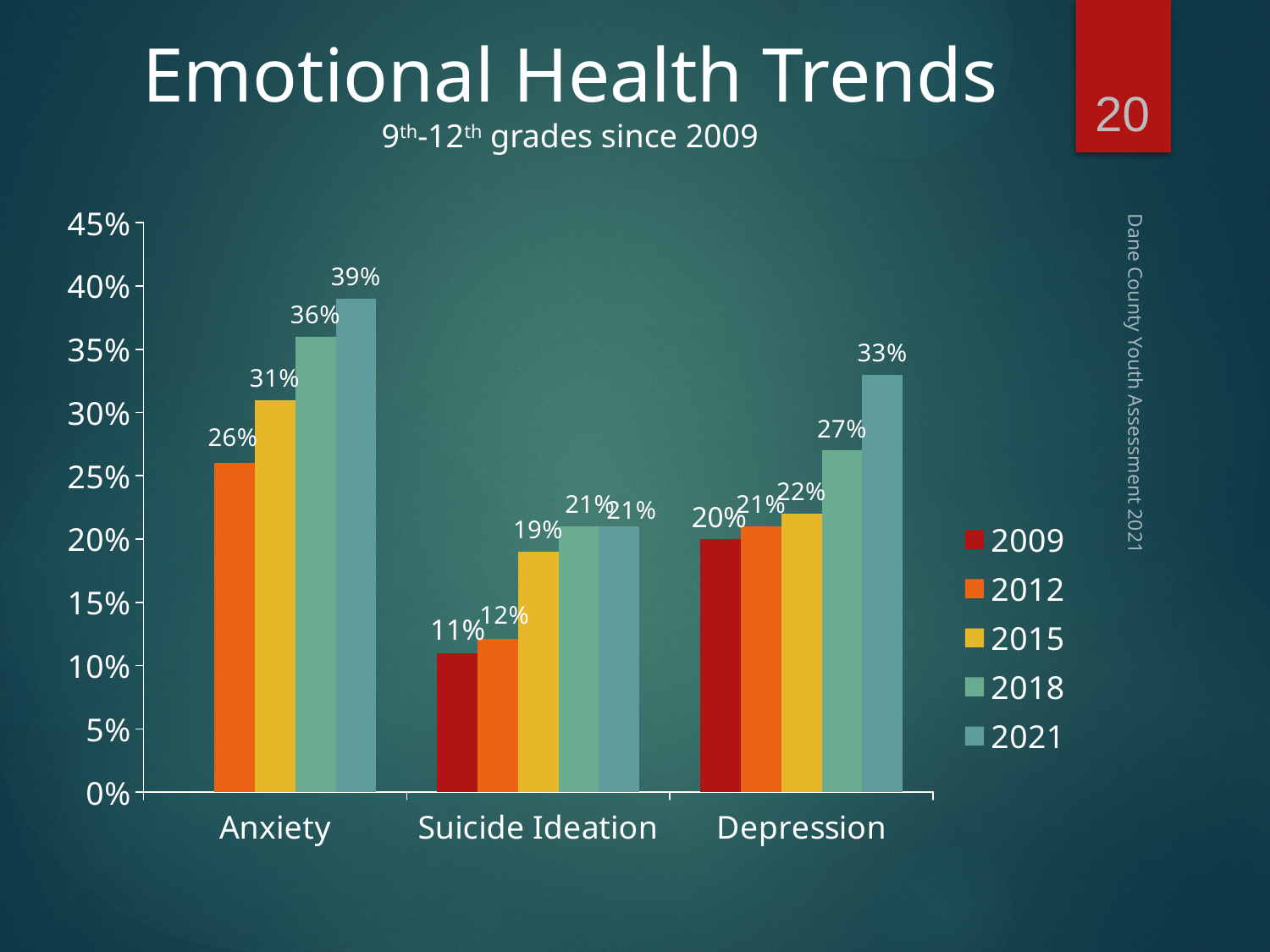
How many categories are shown on the x axis? 3 Which category has the lowest value in 2015? Suicide Ideation What is the difference between the Anxiety values for 2021 and 2012? 13% Which category has the highest value in 2021? Anxiety How many series does the legend list? 5 What is the value for Suicide Ideation in 2009? 11% Which is larger, the 2021 value for Depression or the 2018 value for Anxiety? 2018 value for Anxiety What is the value for Depression in 2018? 27% What is the value for Anxiety in 2021? 39% What type of chart is shown on the slide? bar chart Which series is missing a bar for the Anxiety category? 2009 Do the Depression values rise or fall from 2009 to 2021? rise